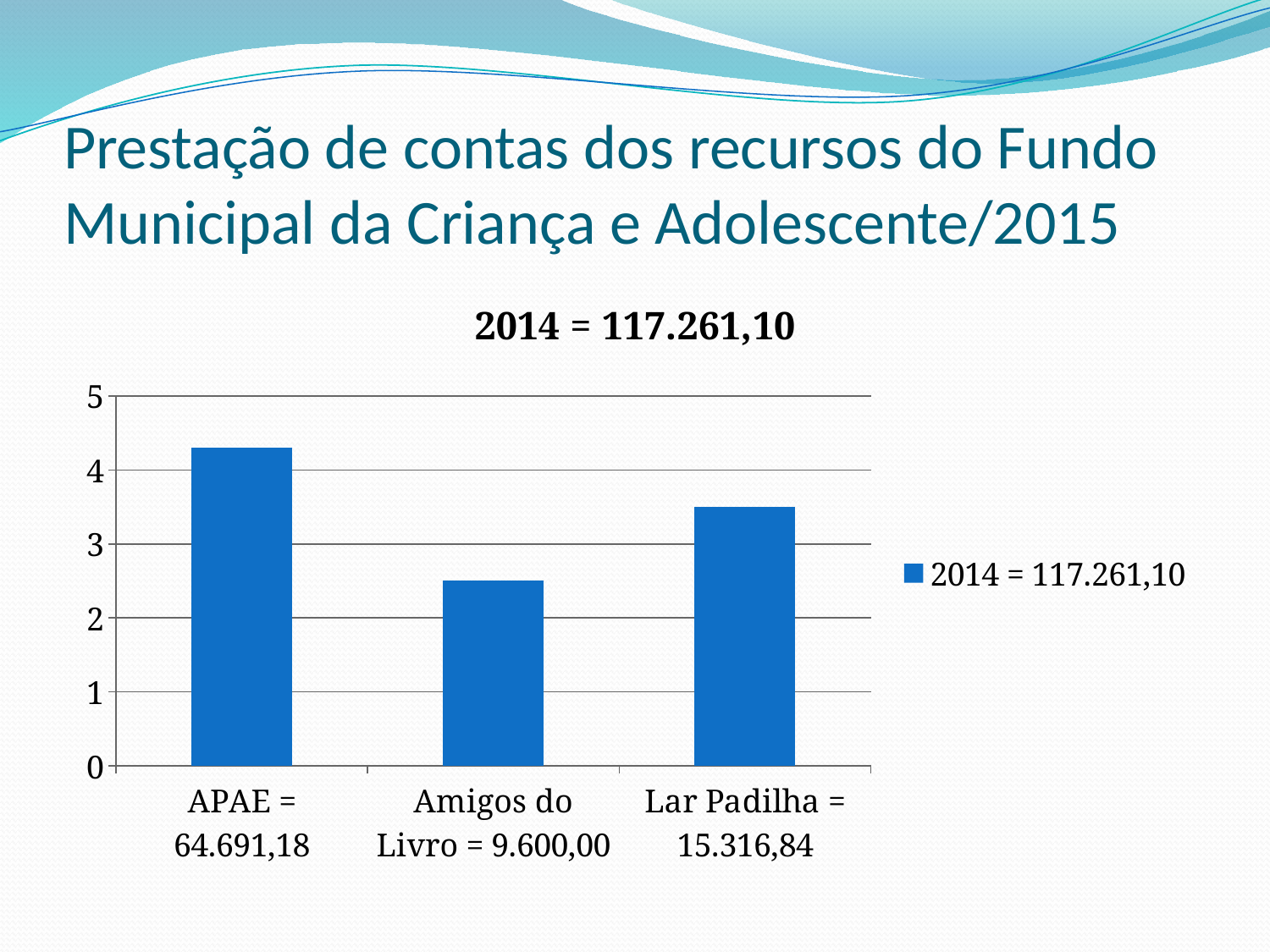
Is the bar for Lar Padilha greater or less than 3? greater What kind of chart is shown on the slide? bar chart Which category has the tallest bar? APAE = 64.691,18 What amount is printed in the category label for APAE? 64.691,18 What amount is printed in the category label for Lar Padilha? 15.316,84 What is the title of the chart? 2014 = 117.261,10 How many bars (categories) does the chart show? 3 Which category has the shortest bar? Amigos do Livro = 9.600,00 How many series does the legend list? 1 Which bar is taller, Lar Padilha or Amigos do Livro? Lar Padilha Is the bar for Amigos do Livro greater or less than 3? less Is the bar for APAE greater or less than 4? greater